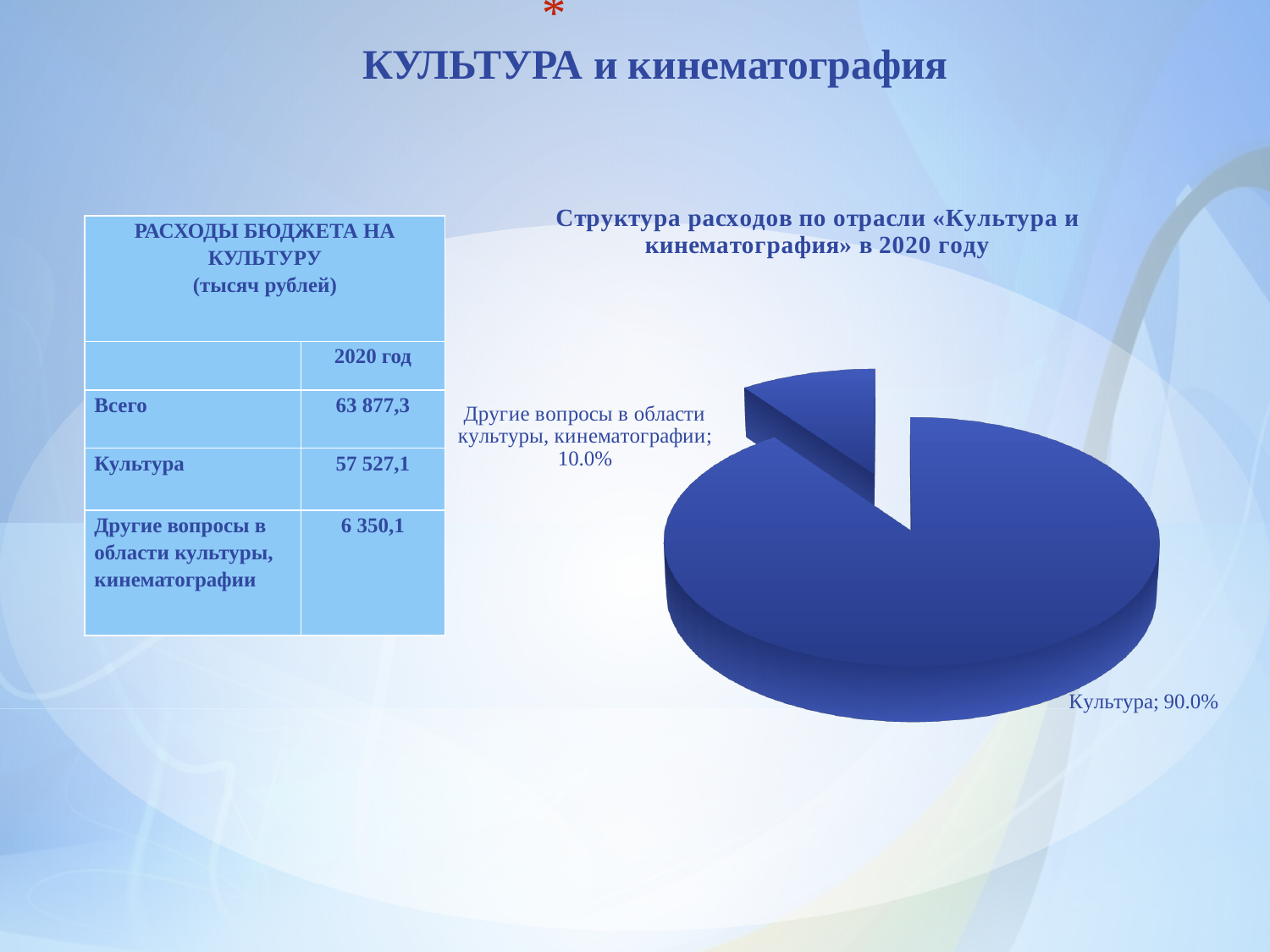
What share of the pie chart does the slice labelled «Другие вопросы в области культуры, кинематографии» represent? 10.0% By how many percentage points does the «Культура» share exceed the «Другие вопросы в области культуры, кинематографии» share in the pie chart? 80.0 percentage points Which year does the pie chart's title refer to? 2020 Which slice of the pie chart is the smallest? Другие вопросы в области культуры, кинематографии What is the title of the chart on the slide? Структура расходов по отрасли «Культура и кинематография» в 2020 году Which is larger in the pie chart: the share for «Культура» or the share for «Другие вопросы в области культуры, кинематографии»? Культура What share of the pie chart does the slice labelled «Культура» represent? 90.0% How many slices does the pie chart have? 2 Which slice of the pie chart is the largest? Культура What type of chart is shown on the slide? Pie chart